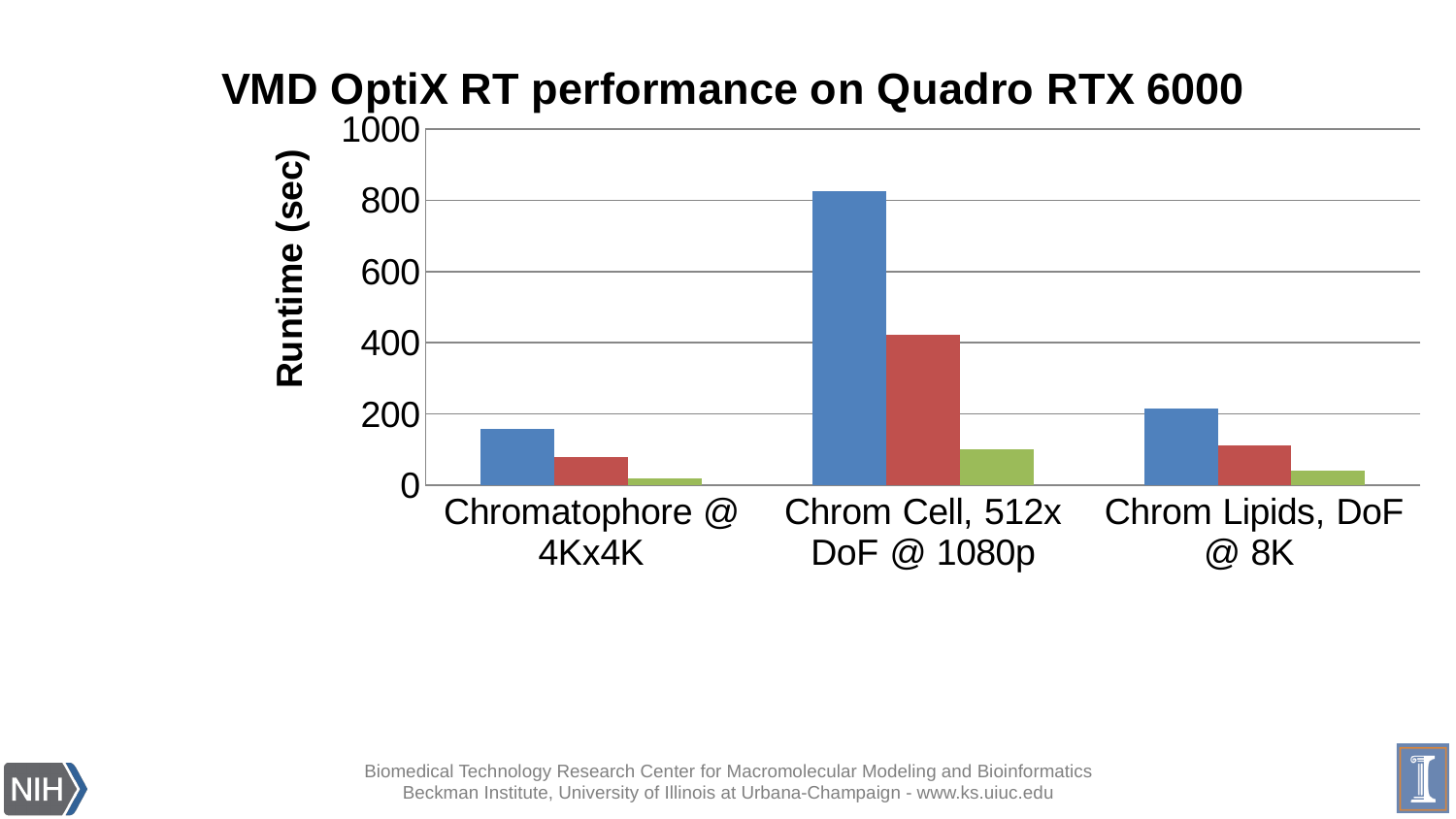
What kind of chart is shown on the slide? bar chart How many bars are plotted for each category? 3 Which category has the tallest blue bar? Chrom Cell, 512x DoF @ 1080p What is the label of the vertical axis? Runtime (sec) Is the blue bar for Chrom Cell, 512x DoF @ 1080p greater or less than 600? greater What is the title of the chart? VMD OptiX RT performance on Quadro RTX 6000 For Chrom Lipids, DoF @ 8K, which is larger, the blue bar or the red bar? the blue bar Is the blue bar for Chromatophore @ 4Kx4K greater or less than 200? less How many categories are shown on the x axis? 3 Which category has the shortest green bar? Chromatophore @ 4Kx4K Is the red bar for Chrom Cell, 512x DoF @ 1080p greater or less than 200? greater